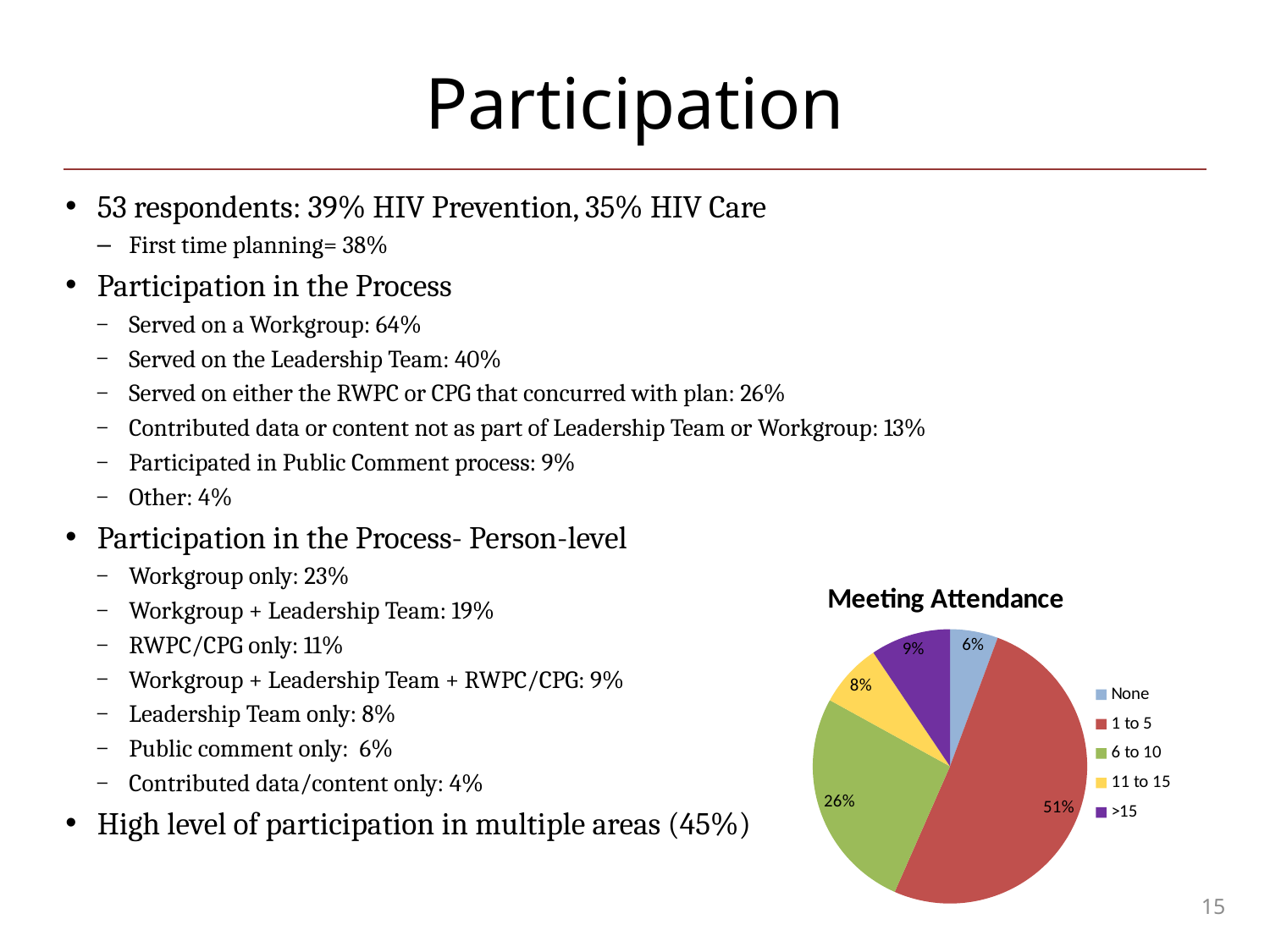
What share of the Meeting Attendance pie is the '6 to 10' slice? 26% What share of the Meeting Attendance pie is the 'None' slice? 6% In the Meeting Attendance chart, what is the difference between the '1 to 5' share and the '6 to 10' share? 25% What share of the Meeting Attendance pie is the '11 to 15' slice? 8% Which category has the smallest slice in the Meeting Attendance pie chart? None Which category has the largest slice in the Meeting Attendance pie chart? 1 to 5 What is the title of the chart on the slide? Meeting Attendance How many categories does the Meeting Attendance pie chart show? 5 What type of chart is the Meeting Attendance chart? pie chart In the Meeting Attendance chart, which is larger: the '>15' slice or the '11 to 15' slice? >15